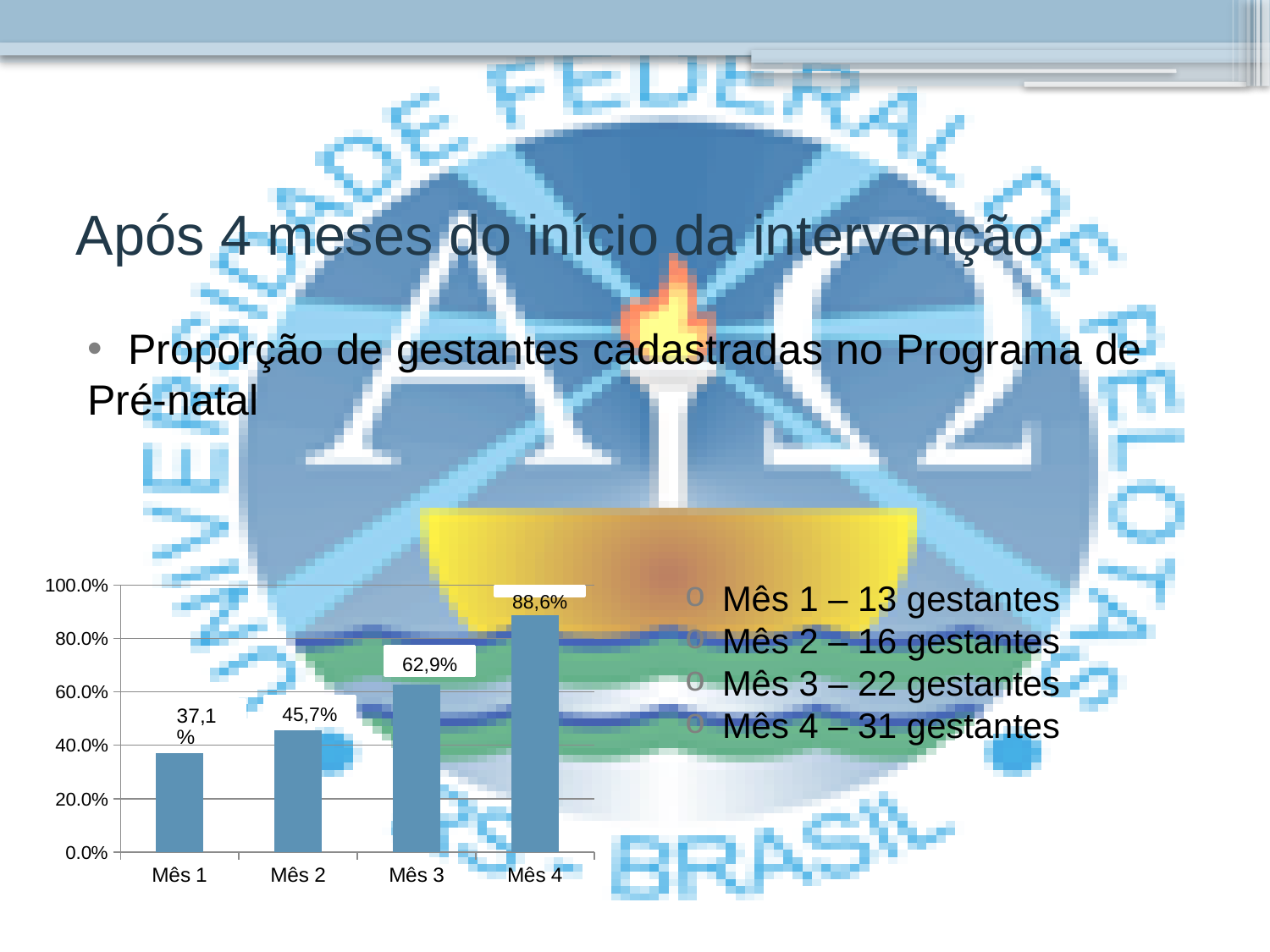
Is the value for Mês 2 greater or less than 60.0%? less What is the difference between the values for Mês 4 and Mês 1? 51,5% Which is larger, the value for Mês 2 or the value for Mês 3? Mês 3 What is the difference between the values for Mês 3 and Mês 2? 17,2% What is the value for Mês 1? 37,1% Which month has the highest value? Mês 4 Do the values rise or fall from Mês 1 to Mês 4? rise What kind of chart is shown on the slide? bar chart What is the value for Mês 3? 62,9% What is the value for Mês 4? 88,6% Which month has the lowest value? Mês 1 How many months are shown on the x axis? 4